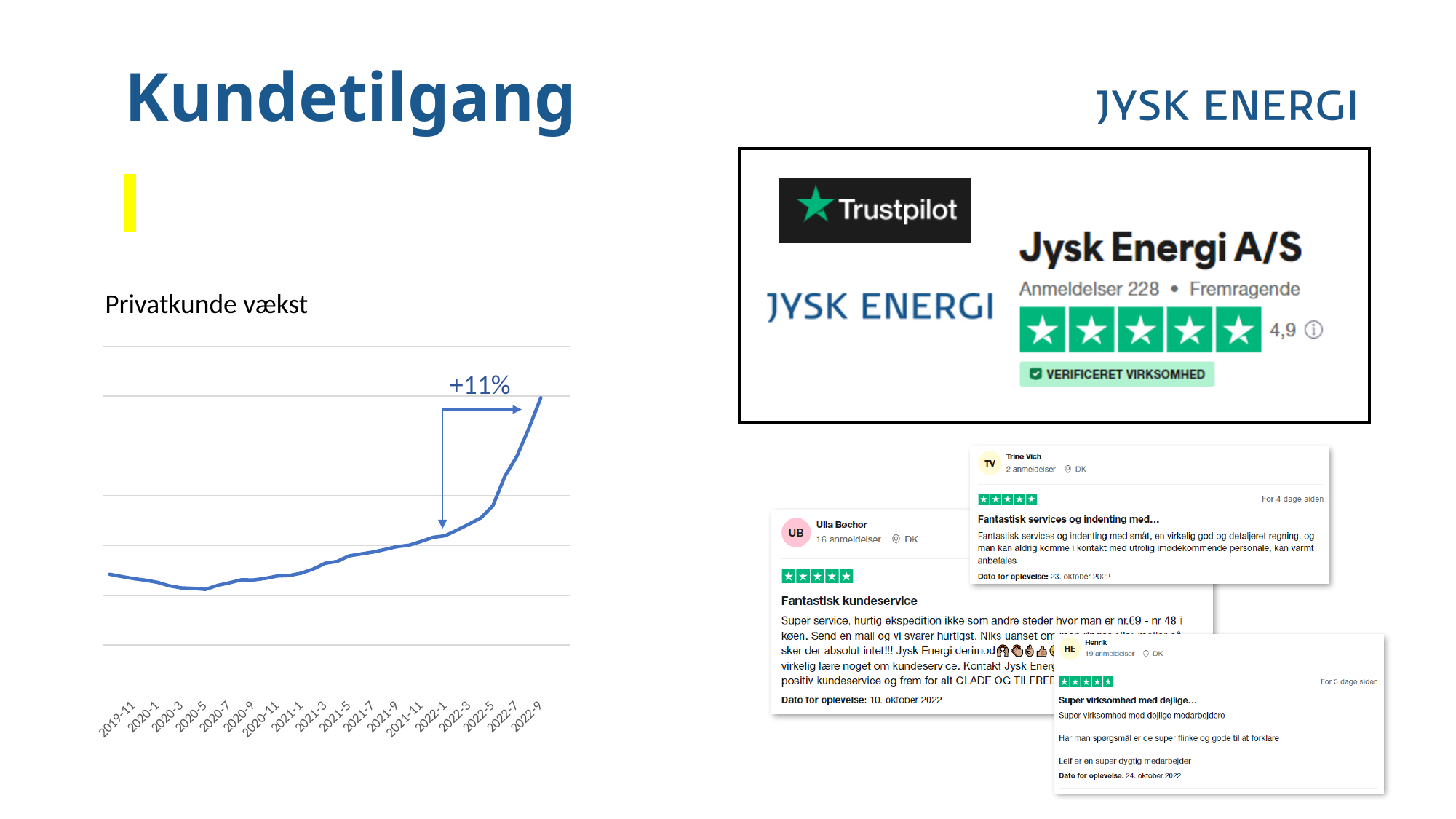
How many x-axis labels are shown on the "Privatkunde vækst" chart? 18 Do the values in the "Privatkunde vækst" chart generally rise or fall from 2019-11 to 2022-9? rise What kind of chart is shown under the heading "Privatkunde vækst"? line chart What is the last x-axis label on the "Privatkunde vækst" chart? 2022-9 In the "Privatkunde vækst" chart, is the value at 2022-9 higher or lower than the value at 2019-11? higher What is the title of the chart on the left of the slide? Privatkunde vækst What percentage change is annotated on the "Privatkunde vækst" chart? +11% In the "Privatkunde vækst" chart, is the value at 2020-5 higher or lower than the value at 2021-9? lower How many lines are plotted in the "Privatkunde vækst" chart? 1 What is the first x-axis label on the "Privatkunde vækst" chart? 2019-11 At which x-axis label does the line in the "Privatkunde vækst" chart reach its lowest point? 2020-5 At which x-axis label does the line in the "Privatkunde vækst" chart reach its highest point? 2022-9